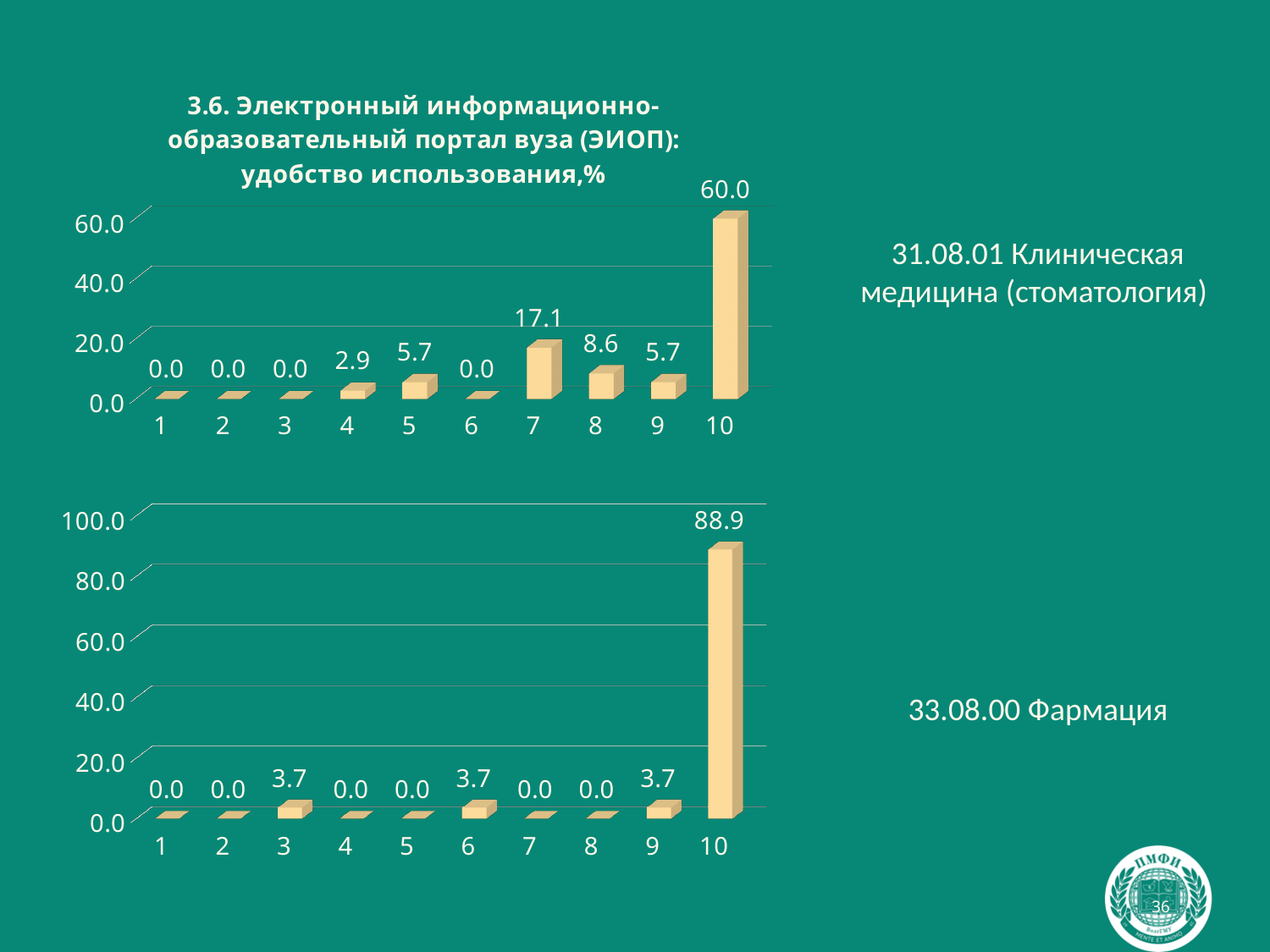
In the top chart (31.08.01 Клиническая медицина (стоматология)), what is the value for category 10? 60.0 In the bottom chart (33.08.00 Фармация), what is the value for category 10? 88.9 In the top chart (31.08.01 Клиническая медицина (стоматология)), what is the difference between the values for category 7 and category 8? 8.5 In the top chart (31.08.01 Клиническая медицина (стоматология)), which is larger, the value for category 4 or category 5? category 5 In the top chart (31.08.01 Клиническая медицина (стоматология)), which category has the highest value? 10 In the bottom chart (33.08.00 Фармация), is the value for category 10 greater or less than 80.0? greater In the top chart (31.08.01 Клиническая медицина (стоматология)), what is the value for category 7? 17.1 In the top chart (31.08.01 Клиническая медицина (стоматология)), what is the value for category 8? 8.6 In the bottom chart (33.08.00 Фармация), what is the difference between the values for category 10 and category 9? 85.2 In the bottom chart (33.08.00 Фармация), what is the value for category 3? 3.7 What kind of chart is the top chart (31.08.01 Клиническая медицина (стоматология))? bar chart In the bottom chart (33.08.00 Фармация), how many categories are shown on the x axis? 10